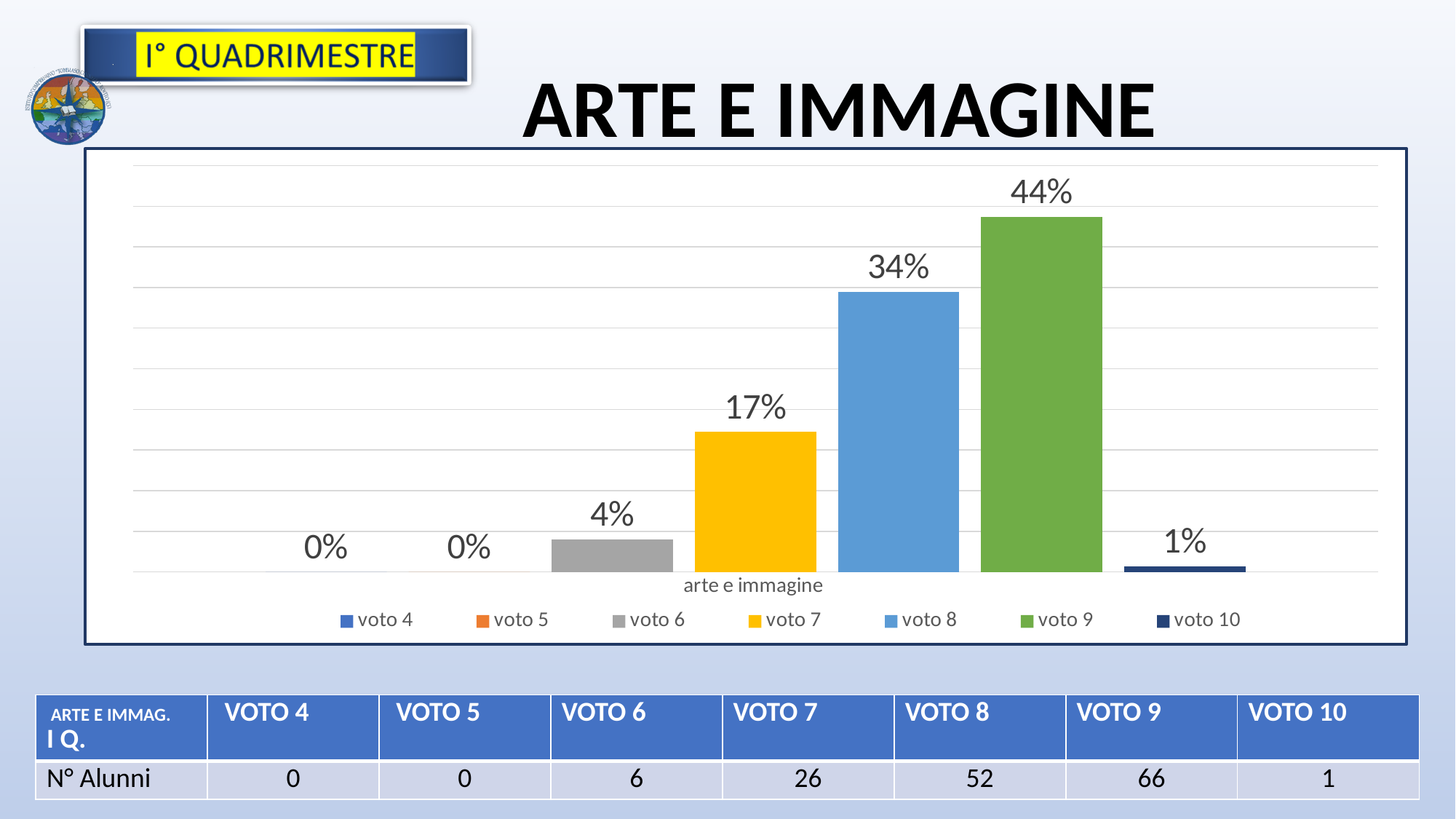
What percentage is shown for voto 6? 4% Which voto has the highest percentage? voto 9 Which is larger, the percentage for voto 7 or for voto 8? voto 8 How many series does the legend list? 7 What is the difference in percentage points between voto 9 and voto 8? 10 What percentage is shown for voto 9? 44% What percentage is shown for voto 7? 17% What percentage is shown for voto 10? 1% What kind of chart is shown? bar chart What colour is the bar for voto 9? green What is the difference in percentage points between voto 8 and voto 7? 17 What is the category label shown on the x axis? arte e immagine